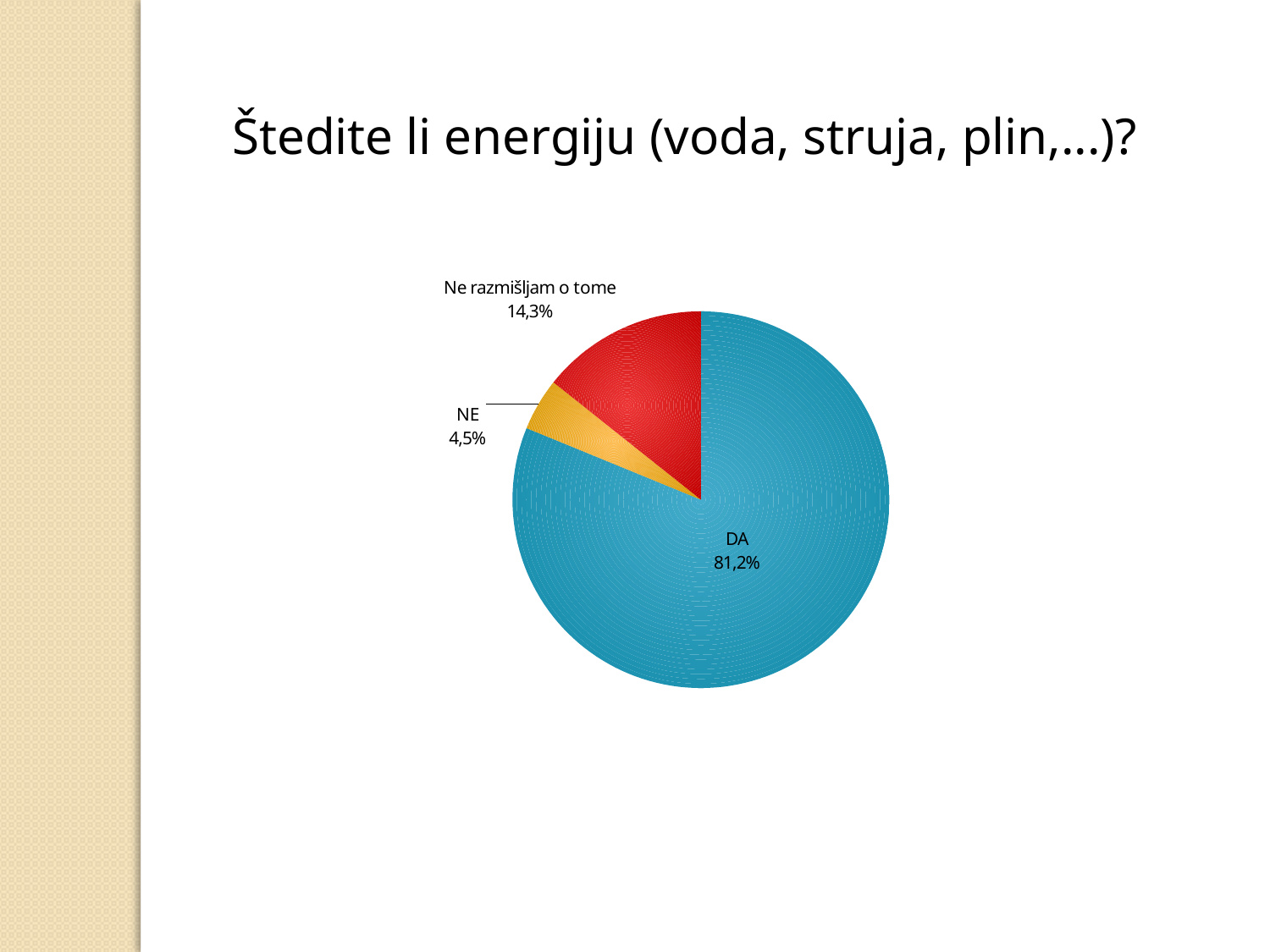
What share of the pie does the NE slice represent? 4,5% What colour is the DA slice of the pie chart? blue Which slice of the pie is the smallest? NE What is the difference in percentage points between the 'Ne razmišljam o tome' slice and the NE slice? 9,8 How many slices does the pie chart have? 3 What is the title of the slide containing the pie chart? Štedite li energiju (voda, struja, plin,...)? Which is larger, the NE slice or the 'Ne razmišljam o tome' slice? Ne razmišljam o tome What kind of chart is shown on the slide? pie chart Which slice of the pie is the largest? DA What share of the pie does the DA slice represent? 81,2% What is the difference in percentage points between the DA slice and the 'Ne razmišljam o tome' slice? 66,9 What share of the pie does the 'Ne razmišljam o tome' slice represent? 14,3%